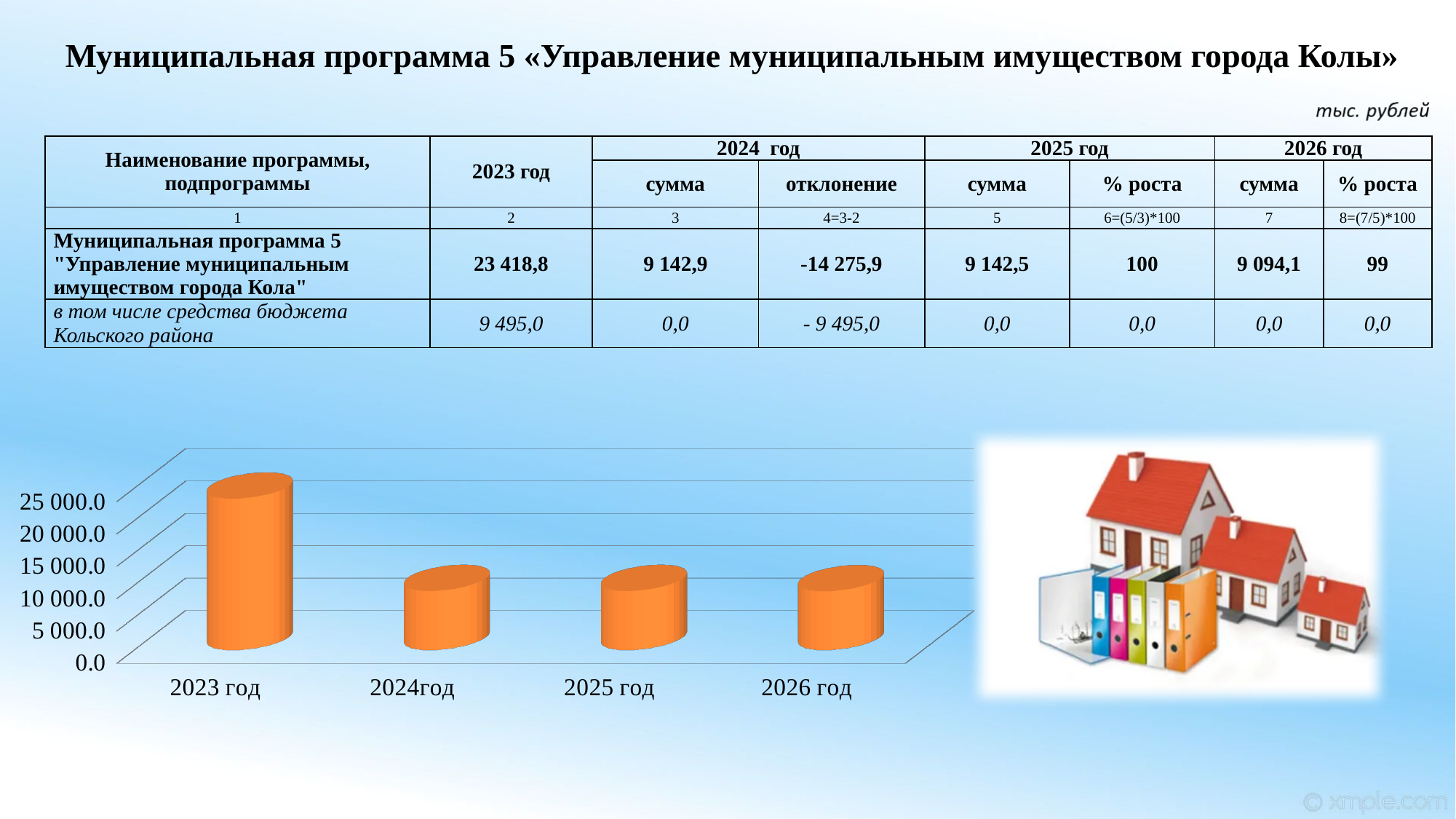
Is the value for 2024год on the chart greater or less than 15 000.0? less Which year has the highest bar on the chart? 2023 год What is the highest tick label shown on the chart's vertical axis? 25 000.0 What colour are the bars on the chart? orange How many categories (years) are plotted on the chart? 4 Which is larger on the chart, the value for 2023 год or the value for 2024год? 2023 год Which is larger on the chart, the value for 2023 год or the value for 2026 год? 2023 год Does the value on the chart rise or fall from 2023 год to 2024год? fall Is the value for 2026 год on the chart greater or less than 15 000.0? less What kind of chart is shown at the bottom left of the slide? bar chart Is the value for 2023 год on the chart greater or less than 20 000.0? greater